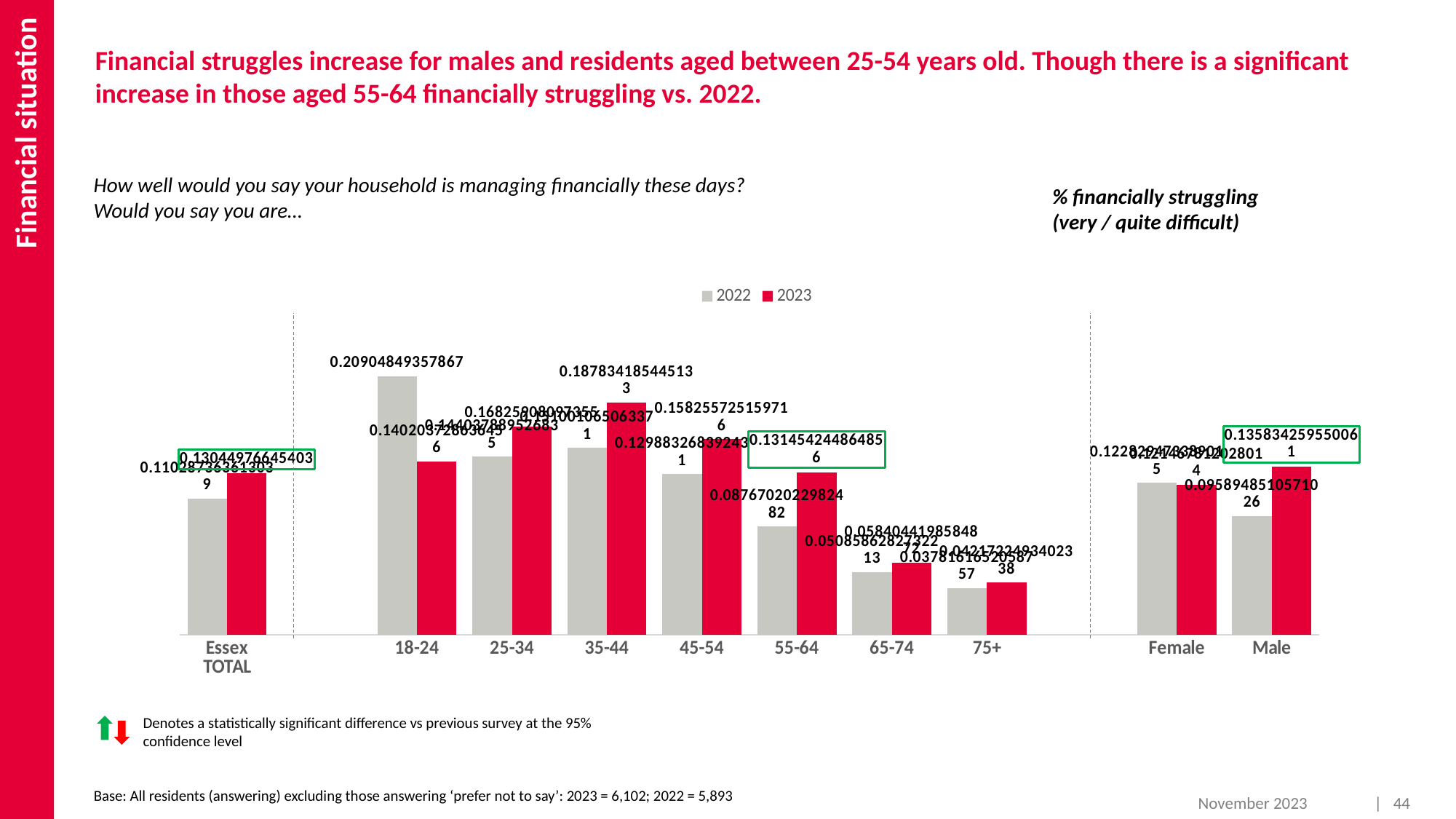
For the 18-24 age group, which is larger: the 2022 value or the 2023 value? 2022 What is the 2022 value for the 18-24 age group? 0.20904849357867 What is the 2023 value for the 55-64 age group? 0.131454244864856 What is the 2023 value for Male? 0.135834259550061 Which category has the highest 2022 value? 18-24 What is the 2023 value for Essex TOTAL? 0.13044976645403 What kind of chart is shown on the slide? bar chart Which colour represents the 2023 series in the legend? red How many categories are shown along the x axis? 10 How many series does the legend list? 2 Which category has the lowest 2022 value? 75+ What is the 2023 value for the 35-44 age group? 0.187834185445133